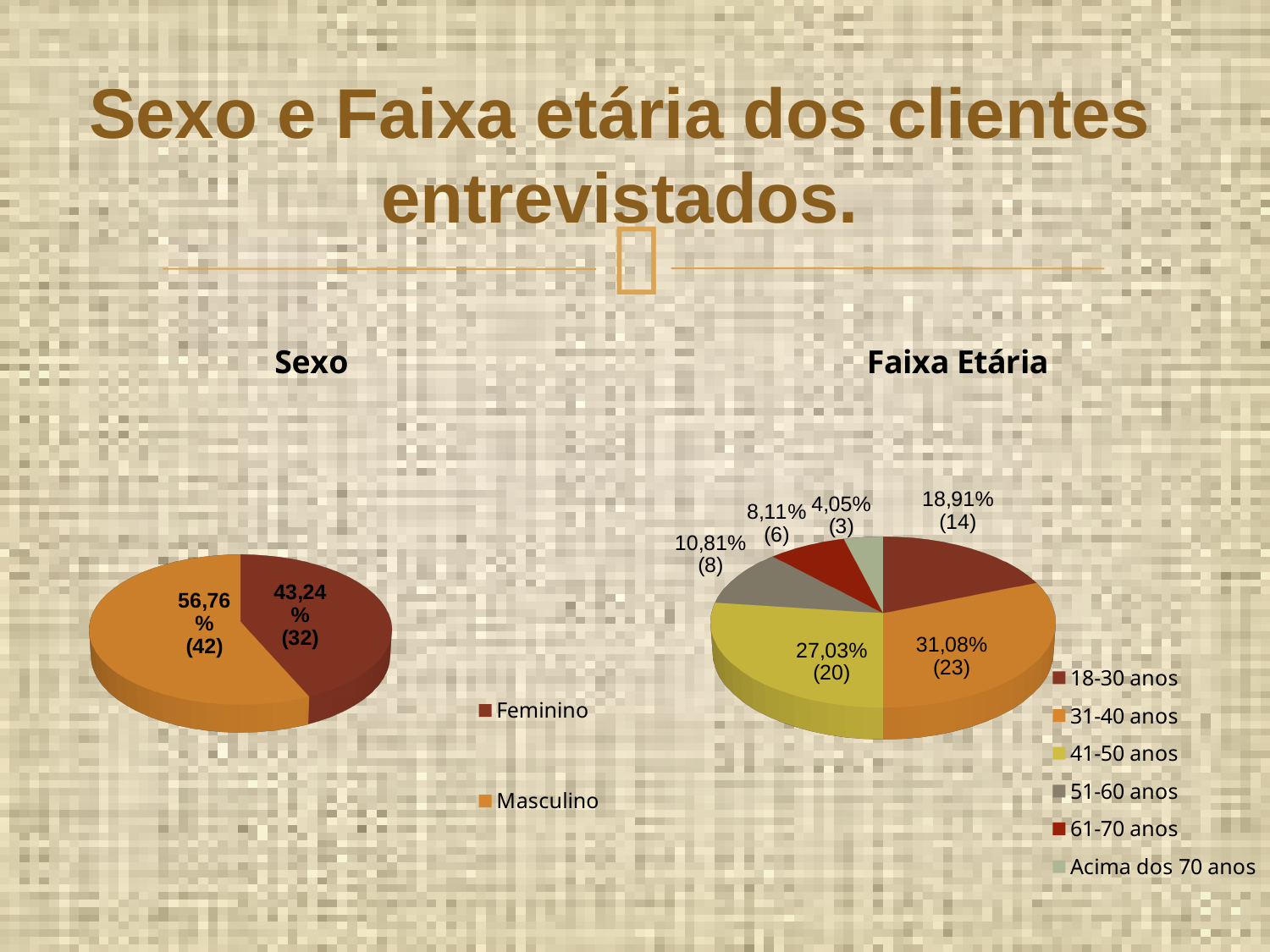
In the 'Faixa Etária' chart, how many clients are in the 41-50 anos group (the count shown in parentheses)? 20 In the 'Faixa Etária' chart, what colour represents the 41-50 anos group? Yellow What type of chart is used for 'Faixa Etária'? Pie chart In the 'Sexo' chart, which category has the larger share, Feminino or Masculino? Masculino In the 'Faixa Etária' chart, what percentage of clients are in the 31-40 anos group? 31,08% In the 'Sexo' chart, how many clients are Feminino (the count shown in parentheses)? 32 In the 'Faixa Etária' chart, how many age groups does the legend list? 6 In the 'Faixa Etária' chart, which age group has the smallest share? Acima dos 70 anos In the 'Sexo' chart, what is the difference in percentage points between Masculino and Feminino? 13,52 In the 'Faixa Etária' chart, which age group has the largest share? 31-40 anos In the 'Sexo' chart, what percentage of the interviewed clients are Masculino? 56,76% In the 'Faixa Etária' chart, what is the difference in percentage points between the 18-30 anos and 51-60 anos groups? 8,10